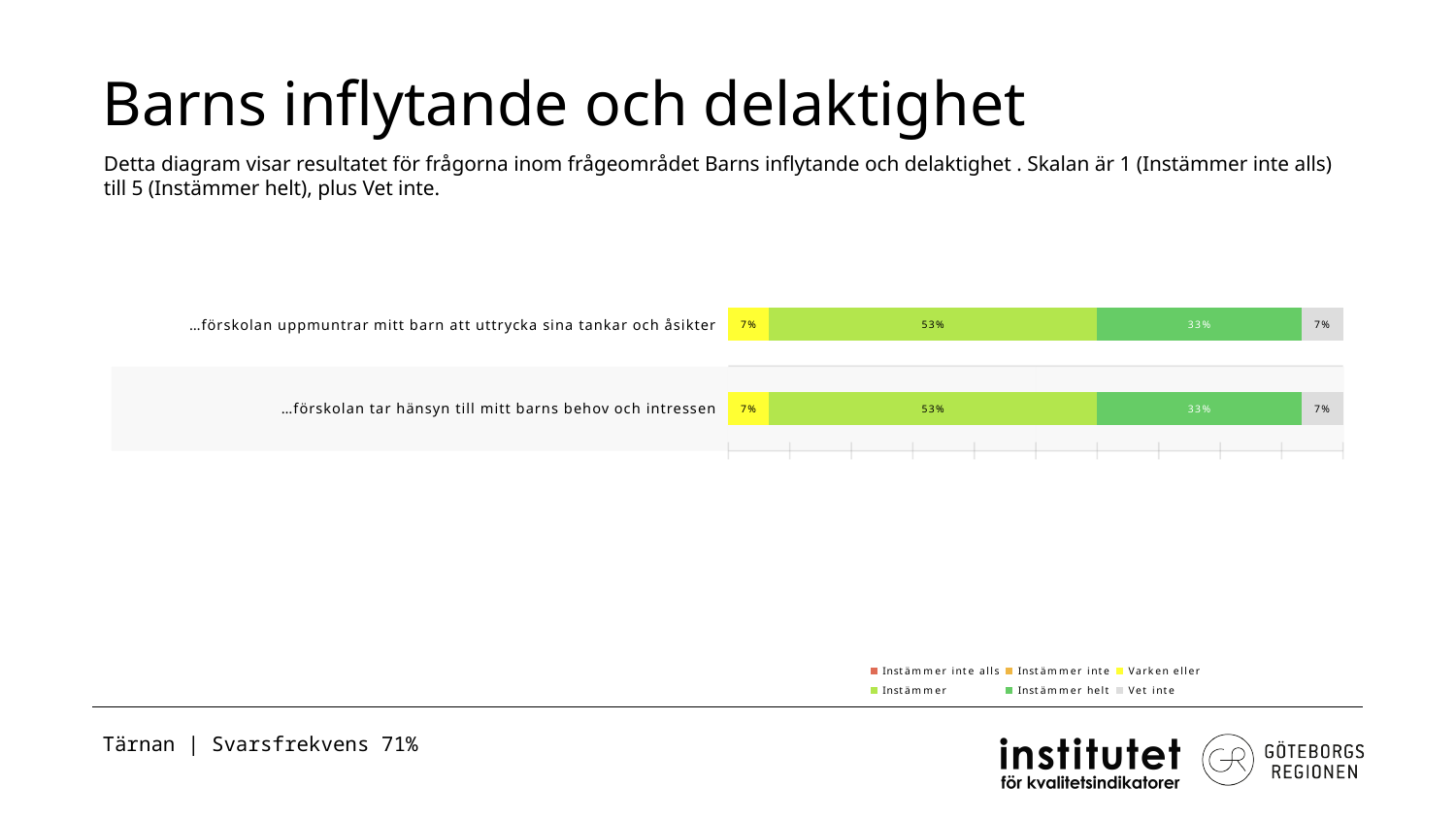
Which series has the largest segment in the bar for "…förskolan tar hänsyn till mitt barns behov och intressen"? Instämmer What is the value for "Varken eller" for "…förskolan tar hänsyn till mitt barns behov och intressen"? 7% What kind of chart is shown on the slide? Stacked bar chart What is the total of the labelled segments in the bar for "…förskolan uppmuntrar mitt barn att uttrycka sina tankar och åsikter"? 100% What is the value for "Vet inte" for "…förskolan uppmuntrar mitt barn att uttrycka sina tankar och åsikter"? 7% Which is larger for "…förskolan tar hänsyn till mitt barns behov och intressen": the "Instämmer" value or the "Instämmer helt" value? Instämmer How many categories (questions) are plotted in the chart? 2 Which legend entry is shown in yellow? Varken eller What is the value for "Instämmer" for "…förskolan uppmuntrar mitt barn att uttrycka sina tankar och åsikter"? 53% What is the value for "Instämmer helt" for "…förskolan tar hänsyn till mitt barns behov och intressen"? 33% What is the difference between the "Instämmer" and "Instämmer helt" values for "…förskolan uppmuntrar mitt barn att uttrycka sina tankar och åsikter"? 20% How many series does the legend list? 6